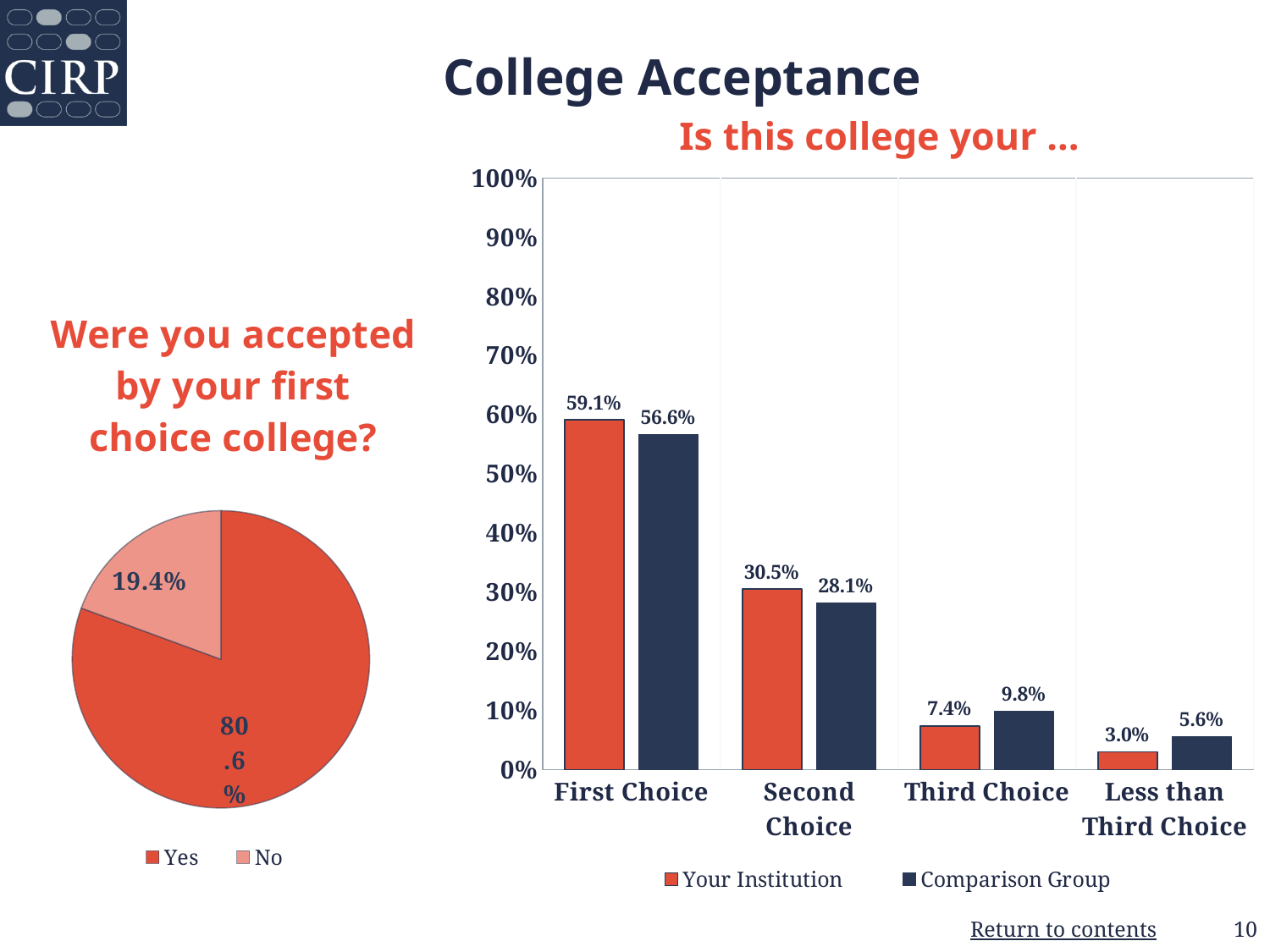
In the bar chart 'Is this college your ...', do the values for Your Institution rise or fall from First Choice to Less than Third Choice? fall In the bar chart 'Is this college your ...', how many categories are shown on the x axis? 4 In the bar chart 'Is this college your ...', what is the value for Comparison Group for Second Choice? 28.1% In the bar chart 'Is this college your ...', what is the value for Your Institution for Less than Third Choice? 3.0% In the bar chart 'Is this college your ...', what is the value for Your Institution for First Choice? 59.1% What kind of chart is the chart on the left of the slide? pie chart In the bar chart 'Is this college your ...', which category has the highest value for Comparison Group? First Choice In the pie chart 'Were you accepted by your first choice college?', what share of the pie is No? 19.4% In the bar chart 'Is this college your ...', which category has the lowest value for Your Institution? Less than Third Choice In the bar chart 'Is this college your ...', what is the difference between Your Institution and Comparison Group for Third Choice? 2.4% In the bar chart 'Is this college your ...', which is larger for Second Choice: Your Institution or Comparison Group? Your Institution In the bar chart 'Is this college your ...', how many series does the legend list? 2